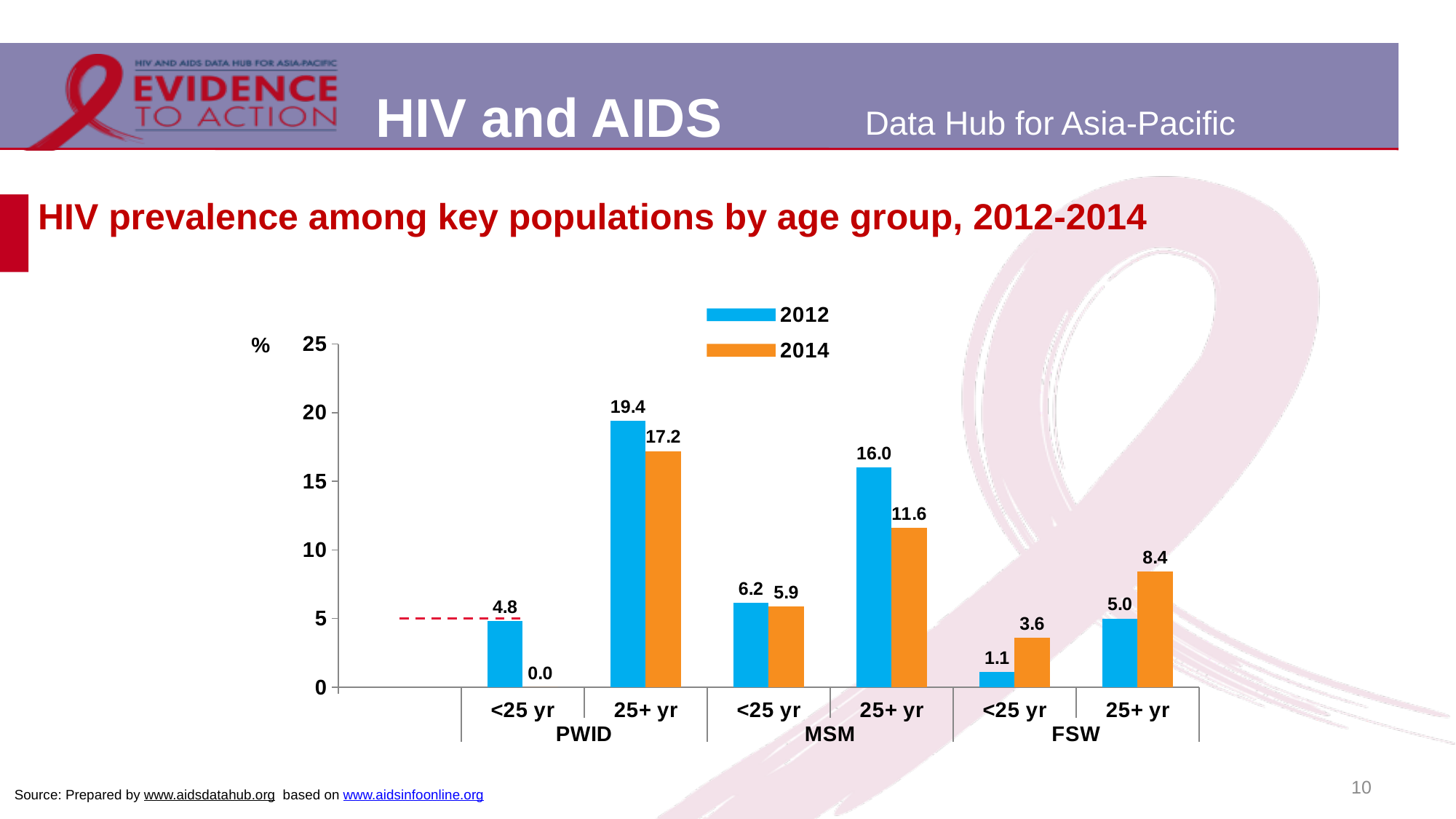
What is the difference between the 2012 and 2014 values for MSM aged 25+ yr? 4.4 Which colour represents the 2014 series? Orange What is the 2014 HIV prevalence among MSM aged 25+ yr? 11.6 How many series does the legend list? 2 Which category has the highest 2012 value? PWID 25+ yr How many age-group categories are shown on the x axis? 6 Which category has the lowest 2014 value? PWID <25 yr What is the 2014 value for PWID aged <25 yr? 0.0 What kind of chart is shown on the slide? Bar chart What is the 2012 HIV prevalence among PWID aged 25+ yr? 19.4 For FSW aged 25+ yr, which year has the larger value, 2012 or 2014? 2014 What is the 2014 value for FSW aged <25 yr? 3.6